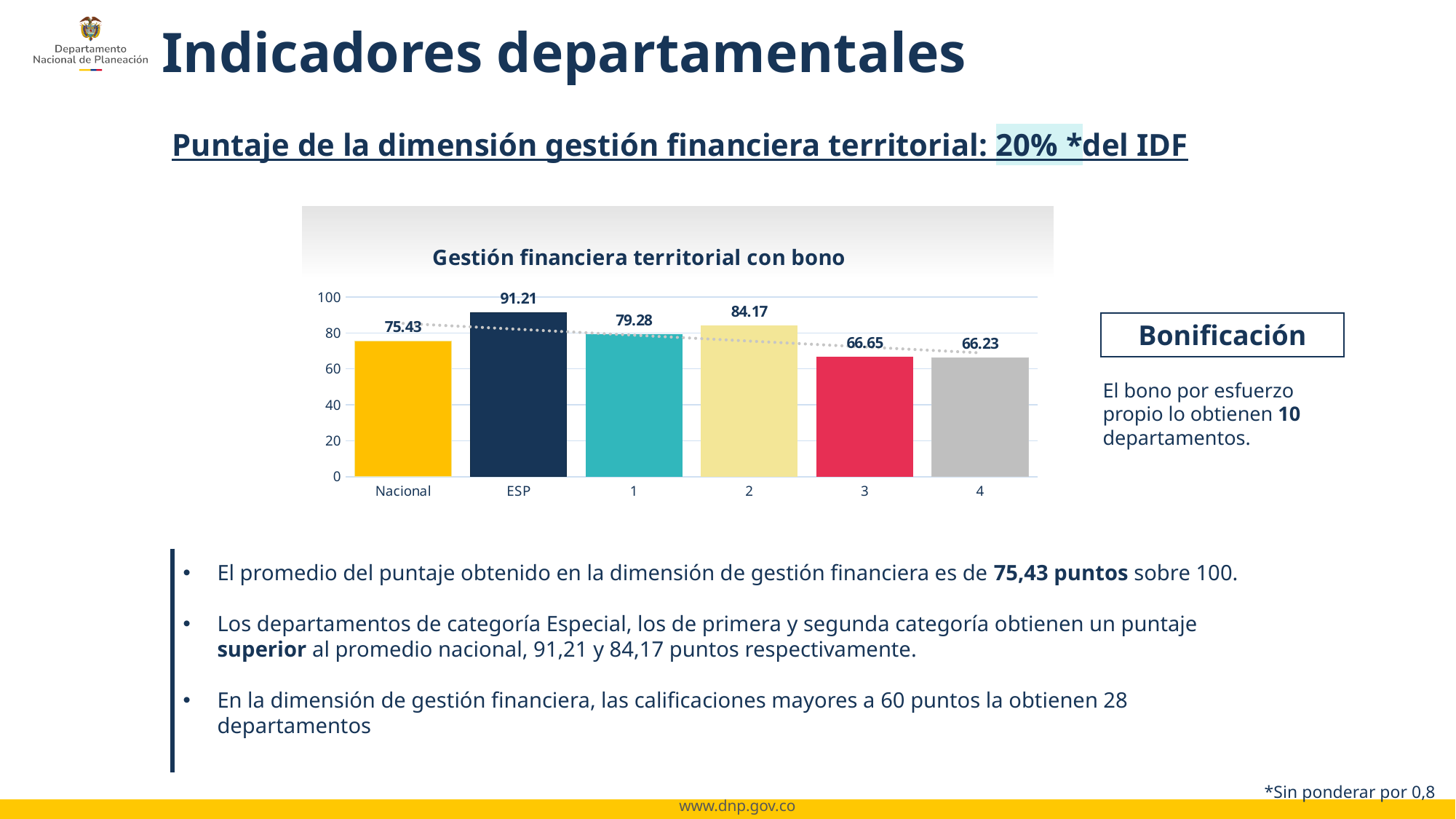
What is the value for category 2 in the chart? 84.17 What is the value for Nacional in the chart? 75.43 What type of chart is shown on the slide? bar chart Which category has the highest value in the chart? ESP What is the value for category 4 in the chart? 66.23 What is the difference between the values for ESP and Nacional? 15.78 What is the value for ESP in the chart 'Gestión financiera territorial con bono'? 91.21 How many categories are shown on the x axis of the chart? 6 Is the value for Nacional greater or less than 80? less Which category has the lowest value in the chart? 4 Which has a larger value, category 1 or category 3? 1 What is the difference between the values for category 2 and category 1? 4.89